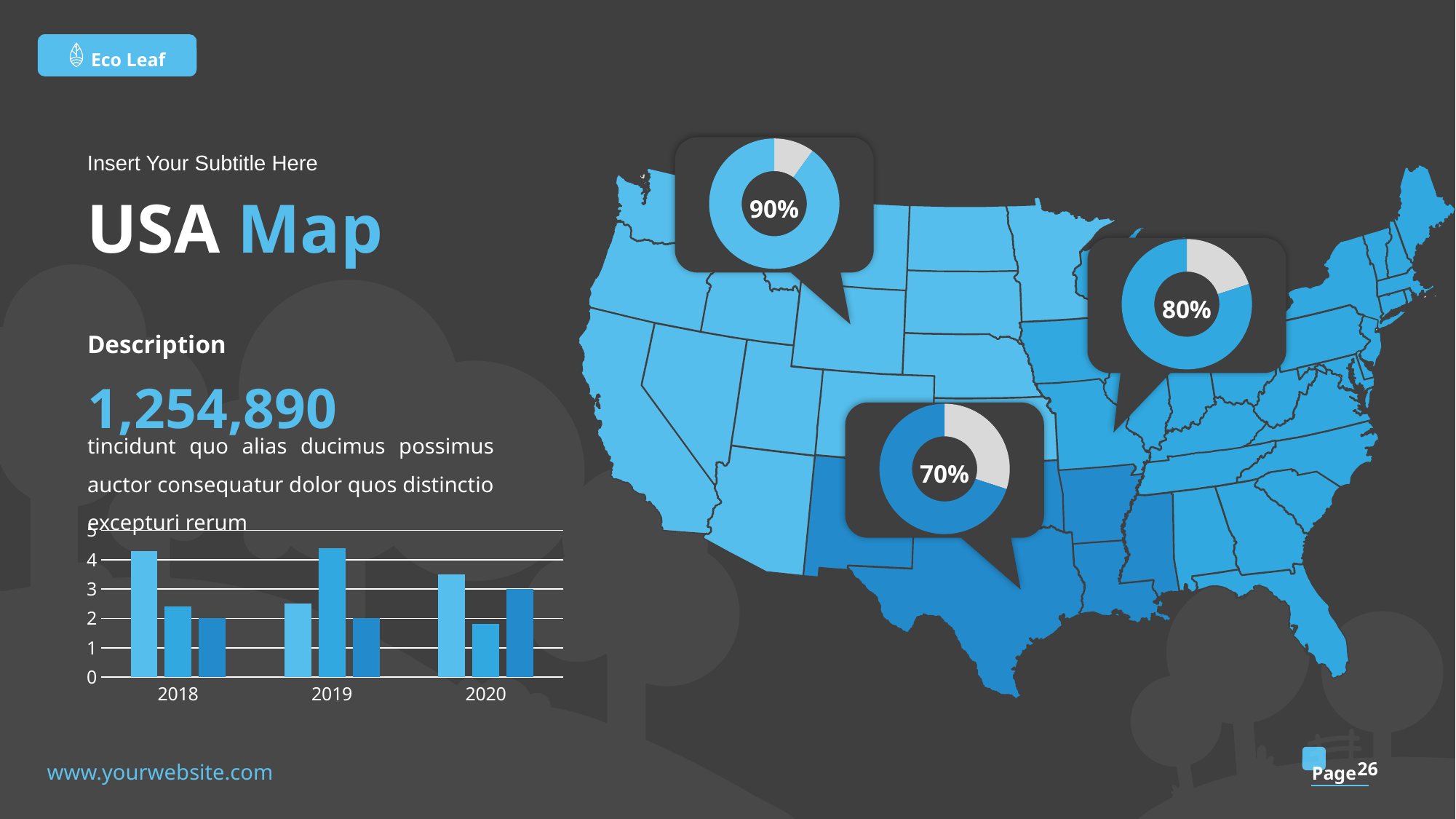
In the bar chart, which year has the tallest first (lightest) bar, 2018 or 2019? 2018 In the bar chart, is the value of the first (lightest) bar for 2020 greater or less than 3? greater What percentage is shown in the donut chart at the top left of the map? 90% What kind of chart is shown at the bottom left of the slide? bar chart In the bar chart, is the value of the first (lightest) bar for 2019 greater or less than 3? less In the bar chart, is the value of the first (lightest) bar for 2018 greater or less than 4? greater How many bars are plotted for each year in the bar chart? 3 Which of the three donut charts on the map shows the lowest percentage? 70% How many years are shown on the x axis of the bar chart? 3 What is the difference between the highest and lowest percentages shown in the donut charts on the map? 20% What percentage is shown in the donut chart on the right side of the map? 80%